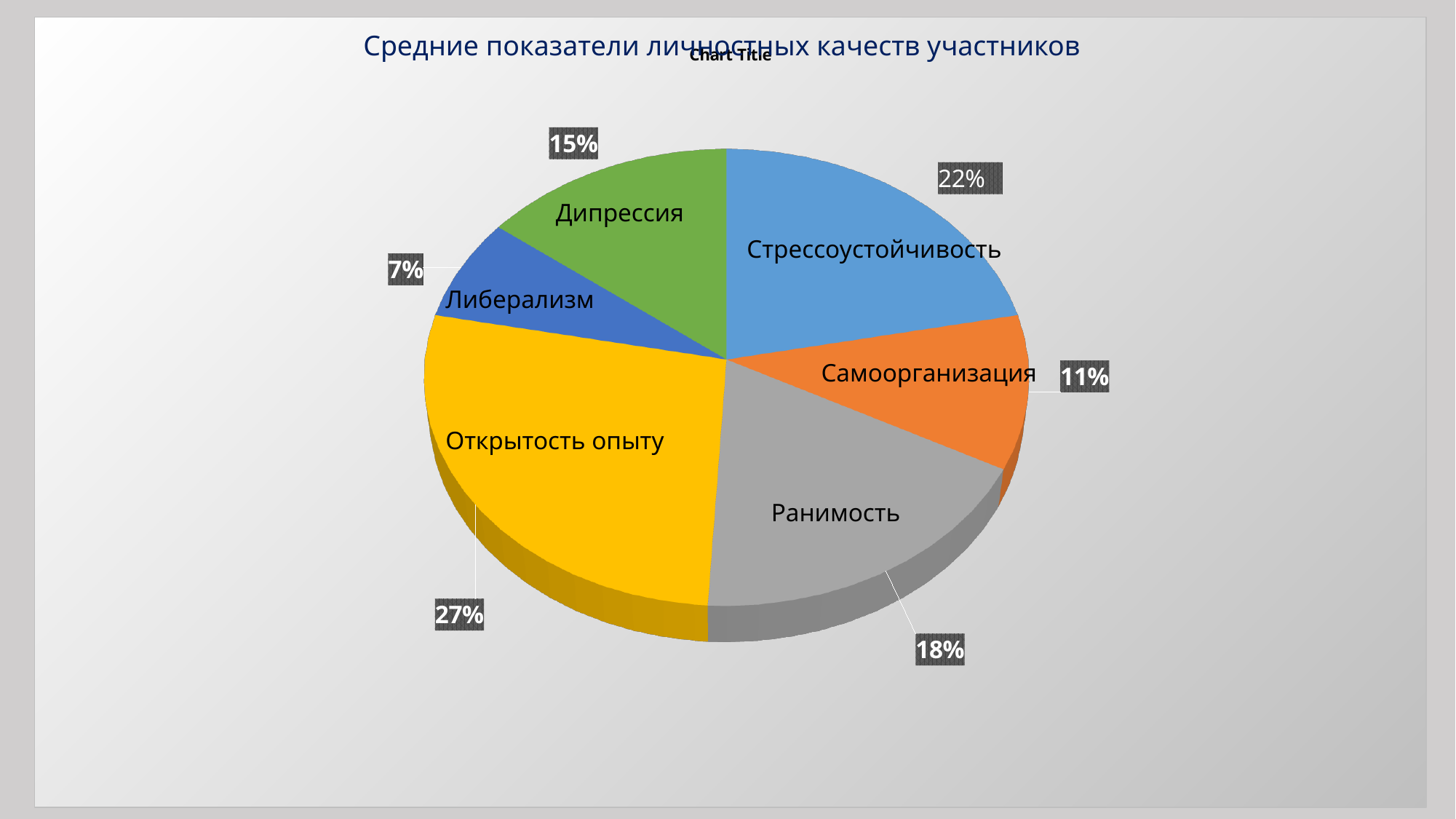
What share of the pie does Либерализм have? 7% What share of the pie does Дипрессия have? 15% What share of the pie does Открытость опыту have? 27% Which is larger, the share of Ранимость or the share of Дипрессия? Ранимость How many slices does the pie chart have? 6 What colour is the Самоорганизация slice? orange Which category has the largest slice of the pie? Открытость опыту Which category has the smallest slice of the pie? Либерализм What is the difference between the shares of Стрессоустойчивость and Самоорганизация? 11% What kind of chart is shown on the slide? pie chart